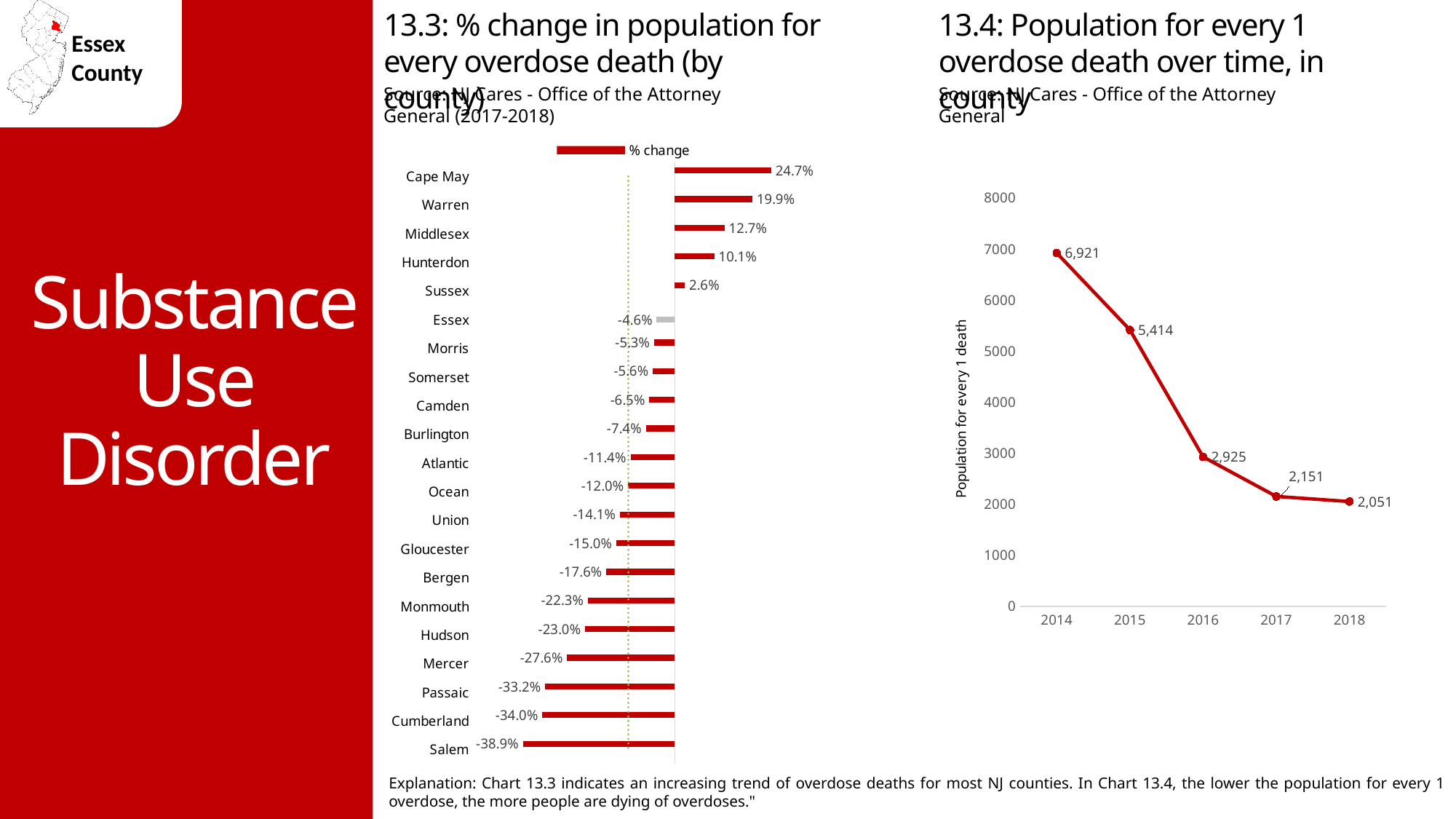
In chart 13.3, which county has the lowest % change? Salem In chart 13.4, do the values rise or fall from 2014 to 2018? Fall What kind of chart is chart 13.4? Line chart In chart 13.4 (Population for every 1 overdose death over time), what is the value for 2016? 2,925 What kind of chart is chart 13.3? Bar chart In chart 13.4, what is the difference between the 2014 and 2018 values? 4,870 In chart 13.3, which county has the highest % change? Cape May In chart 13.3, what is the value for Cape May? 24.7% In chart 13.3, what is the difference between the values for Warren and Middlesex? 7.2% In chart 13.3, how many counties are shown? 21 In chart 13.3, which has a larger % change, Hudson or Mercer? Hudson In chart 13.3 (% change in population for every overdose death), what is the value for Essex? -4.6%